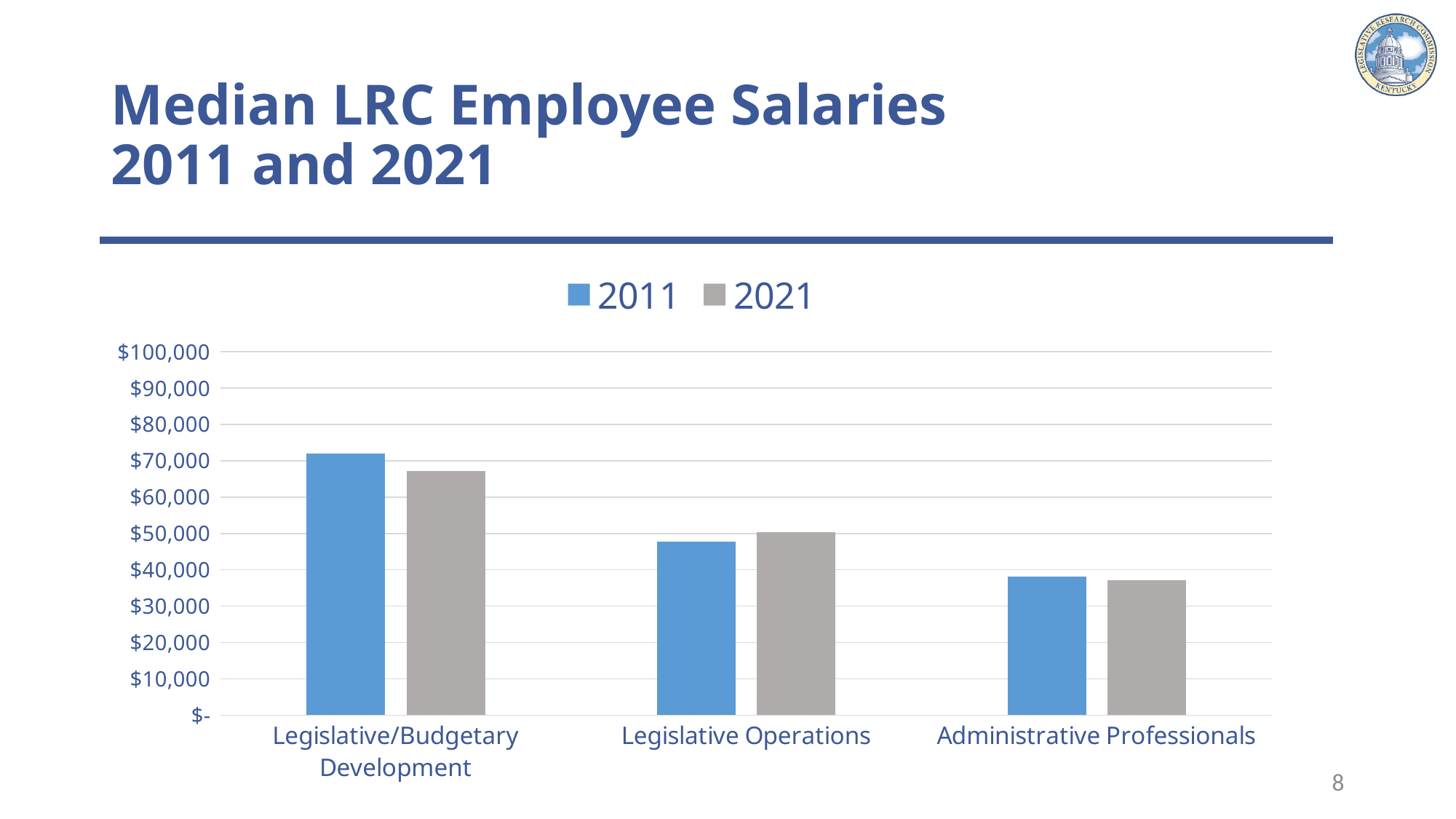
Is the 2011 value for Administrative Professionals greater or less than $40,000? less Is the 2011 value for Legislative/Budgetary Development greater or less than $70,000? greater What is the title of the chart on the slide? Median LRC Employee Salaries 2011 and 2021 Which category has the lowest 2021 median salary? Administrative Professionals Which category has the highest 2011 median salary? Legislative/Budgetary Development For Legislative/Budgetary Development, which year has the larger median salary, 2011 or 2021? 2011 What kind of chart is shown on the slide? Bar chart Is the 2011 value for Legislative Operations greater or less than $50,000? less How many series does the legend list? 2 How many categories are shown on the x axis? 3 For Legislative Operations, which year has the larger median salary, 2011 or 2021? 2021